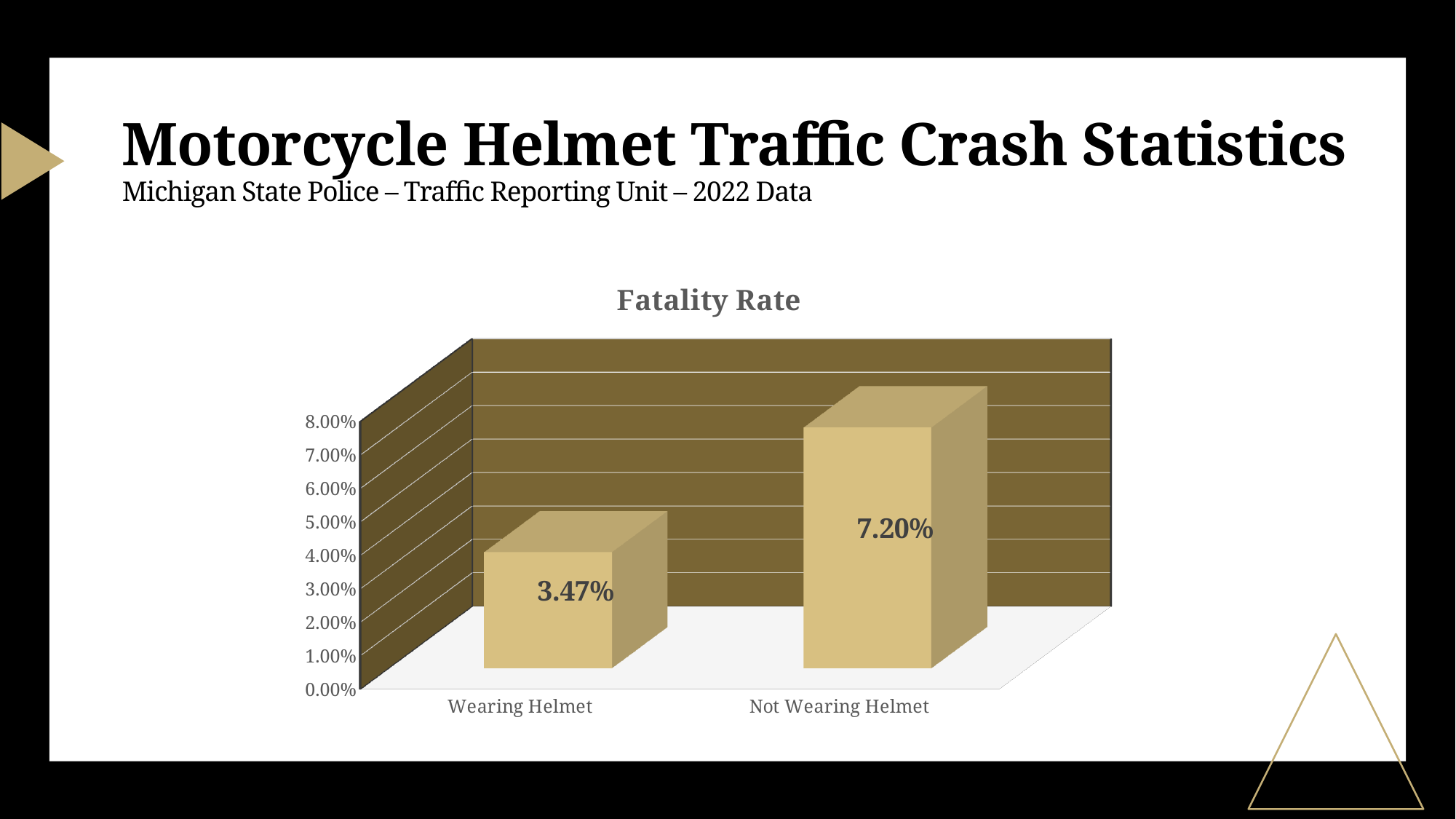
Which is larger, the fatality rate for Wearing Helmet or for Not Wearing Helmet? Not Wearing Helmet What is the difference in fatality rate between Not Wearing Helmet and Wearing Helmet? 3.73% Which category has the lowest fatality rate? Wearing Helmet What kind of chart is shown on the slide? Bar chart What is the highest value shown on the vertical axis of the chart? 8.00% What is the fatality rate for Wearing Helmet? 3.47% Is the fatality rate for Wearing Helmet greater or less than 4.00%? less How many categories are shown in the chart? 2 What is the fatality rate for Not Wearing Helmet? 7.20% Which category has the highest fatality rate? Not Wearing Helmet What is the title of the chart? Fatality Rate Is the fatality rate for Not Wearing Helmet greater or less than 5.00%? greater